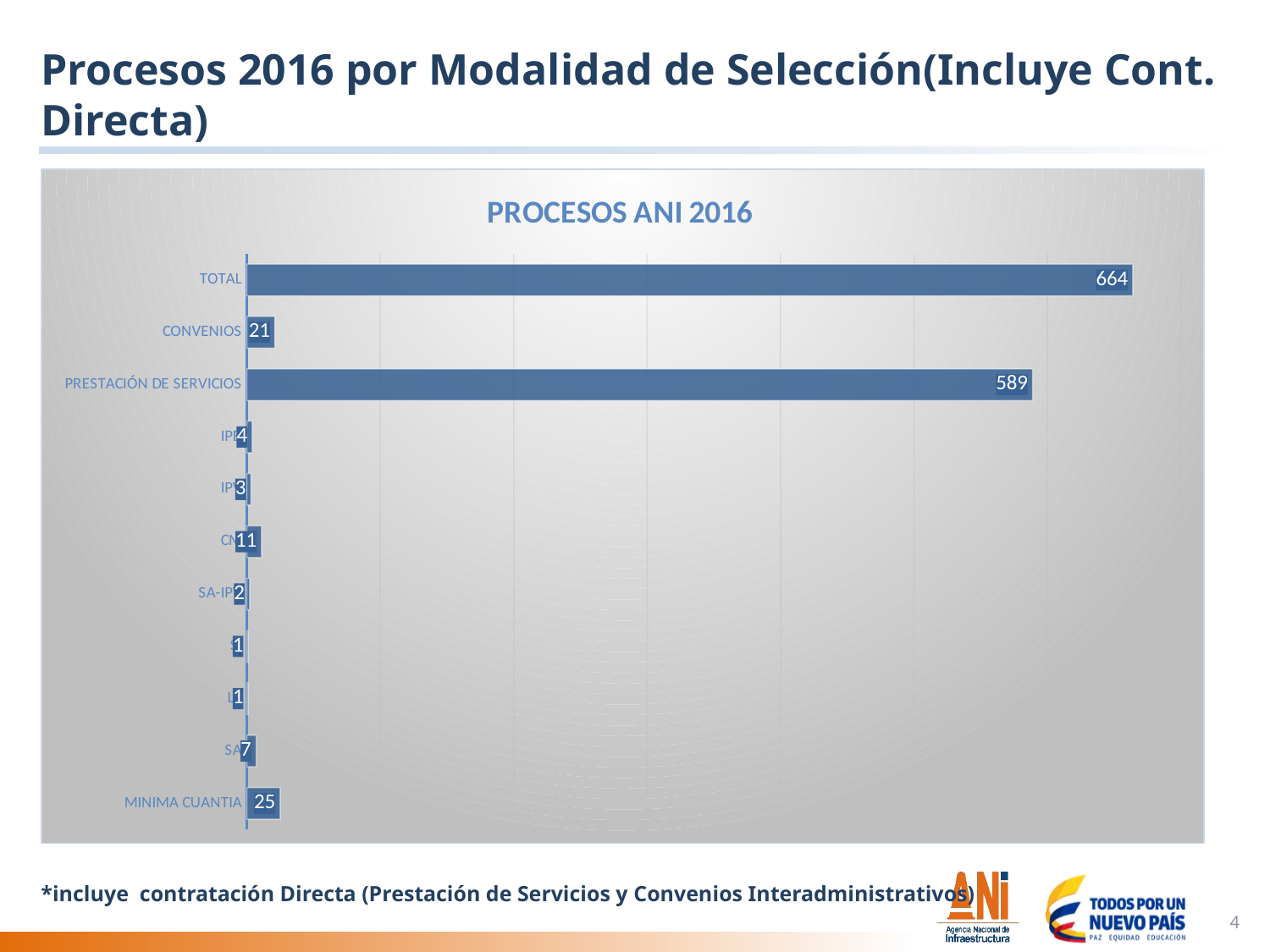
Which category has the highest value in the chart? TOTAL What is the value for TOTAL in the PROCESOS ANI 2016 chart? 664 What is the value for SA-IP? 2 What is the value for CONVENIOS? 21 What is the difference between the TOTAL value and the PRESTACIÓN DE SERVICIOS value? 75 What is the value for PRESTACIÓN DE SERVICIOS? 589 What is the title of the chart? PROCESOS ANI 2016 How many bars are plotted in the chart? 11 What kind of chart is shown on the slide? Bar chart Which is larger, the value for CONVENIOS or the value for MINIMA CUANTIA? MINIMA CUANTIA What is the difference between the MINIMA CUANTIA value and the CONVENIOS value? 4 What is the value for MINIMA CUANTIA? 25